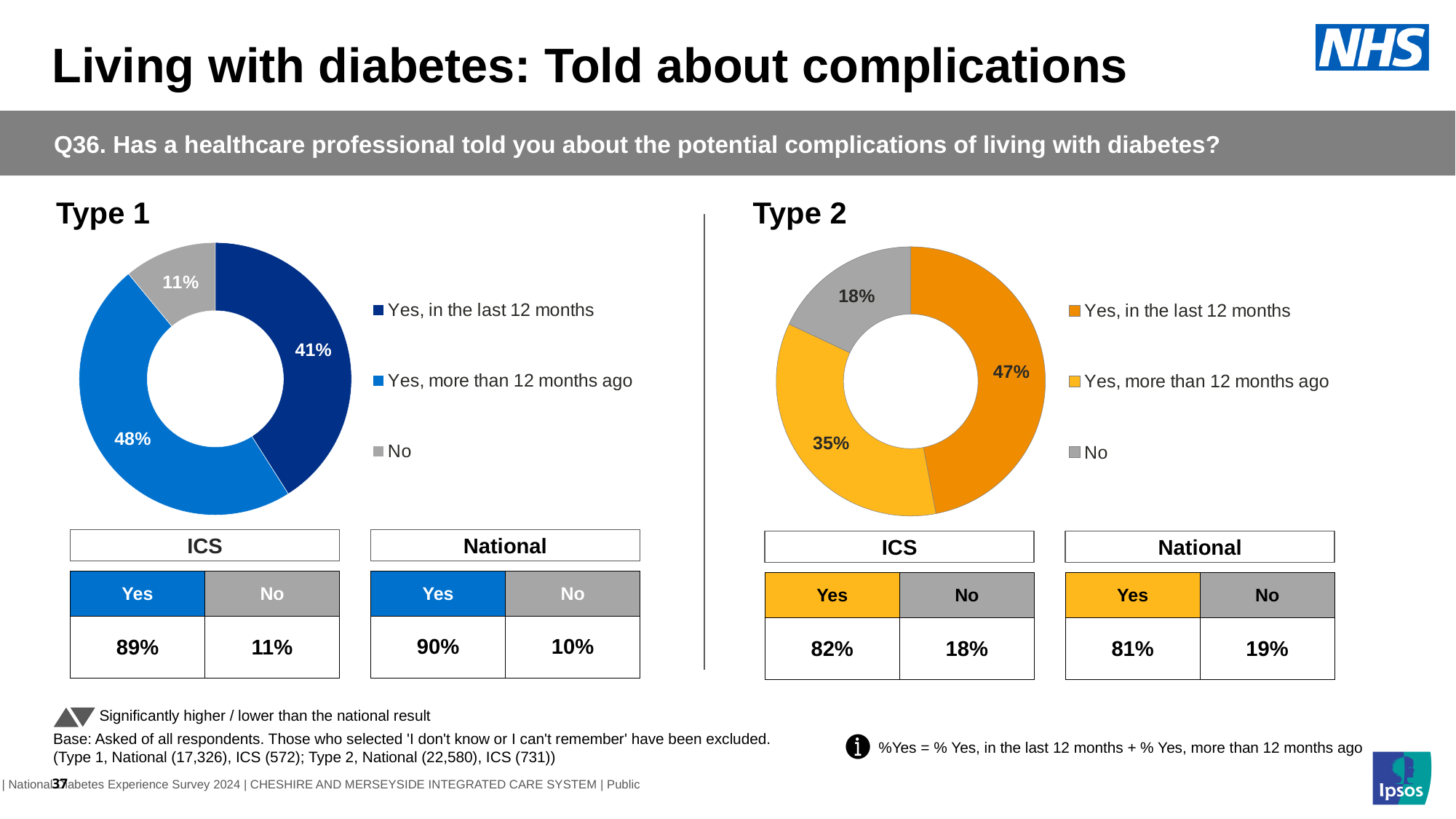
How many categories does the legend of the Type 2 chart list? 3 In the Type 2 chart, what is the difference between the 'Yes, in the last 12 months' share and the 'No' share? 29% In the Type 1 chart, which response has the smallest share? No In the Type 1 chart, what percentage of respondents said 'Yes, in the last 12 months'? 41% In the Type 2 chart, what colour represents 'No'? Grey In the Type 2 chart, which response has the largest share? Yes, in the last 12 months Is the 'No' share larger in the Type 1 chart or the Type 2 chart? Type 2 In the Type 1 chart, what percentage of respondents answered 'No'? 11% In the Type 1 chart, what is the difference between the 'Yes, more than 12 months ago' share and the 'Yes, in the last 12 months' share? 7% In the Type 1 chart, which is larger: 'Yes, in the last 12 months' or 'Yes, more than 12 months ago'? Yes, more than 12 months ago In the Type 2 chart, what percentage of respondents said 'Yes, more than 12 months ago'? 35% What kind of chart is used to show the Type 1 results? Doughnut chart